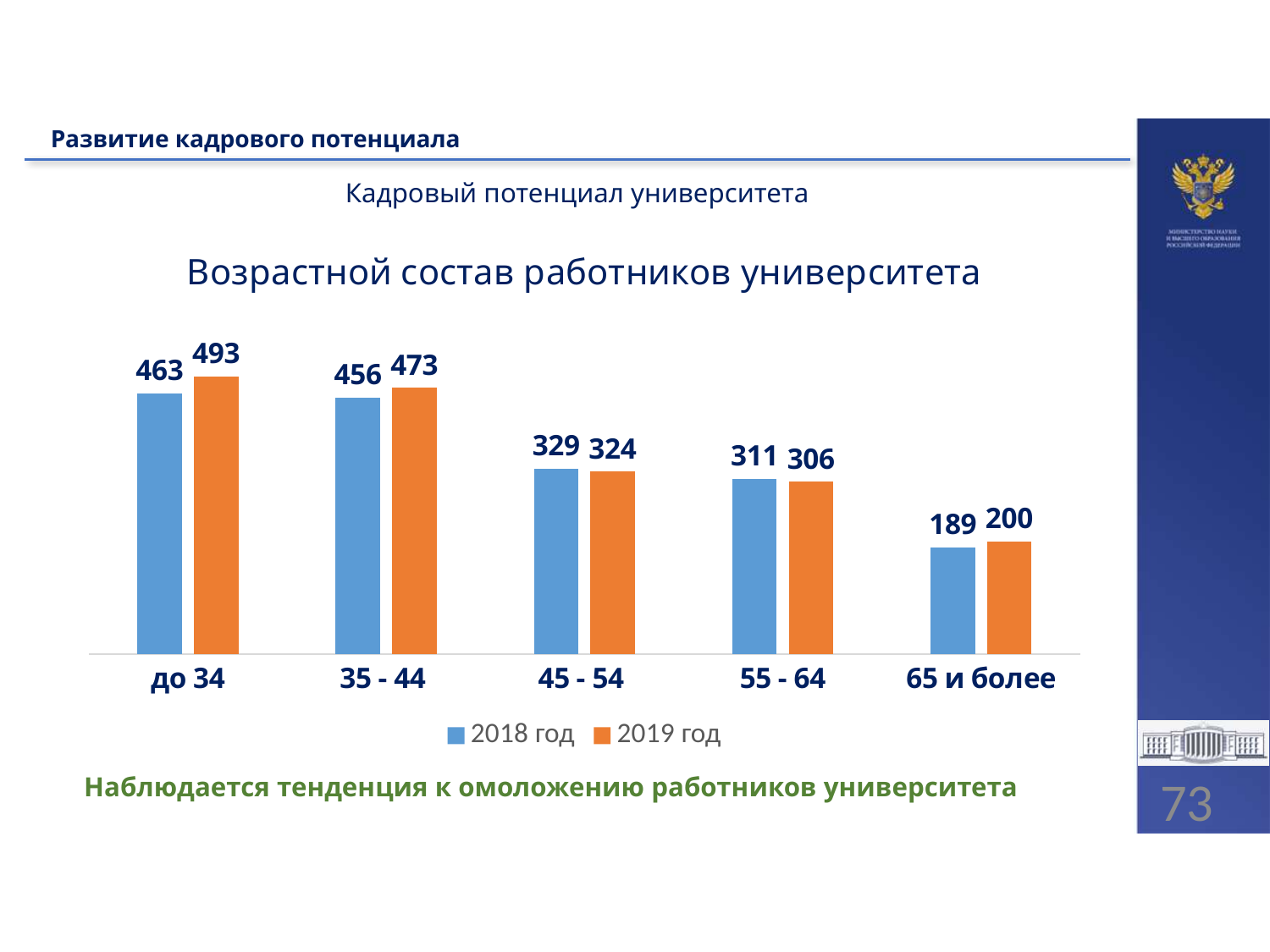
What is the difference between the 2019 год and 2018 год values for the 'до 34' age group? 30 How many series does the legend list? 2 What is the difference between the 2018 год and 2019 год values for the '45 - 54' age group? 5 How many age groups are shown on the x axis? 5 Which age group has the highest value in 2019 год? до 34 What is the value for the 'до 34' age group in 2019 год? 493 What is the value for the '55 - 64' age group in 2018 год? 311 Which age group has the lowest value in 2018 год? 65 и более Which is larger for the '35 - 44' age group: the 2018 год value or the 2019 год value? 2019 год What kind of chart is shown on the slide? bar chart What is the title of the chart? Возрастной состав работников университета What is the value for the '65 и более' age group in 2019 год? 200